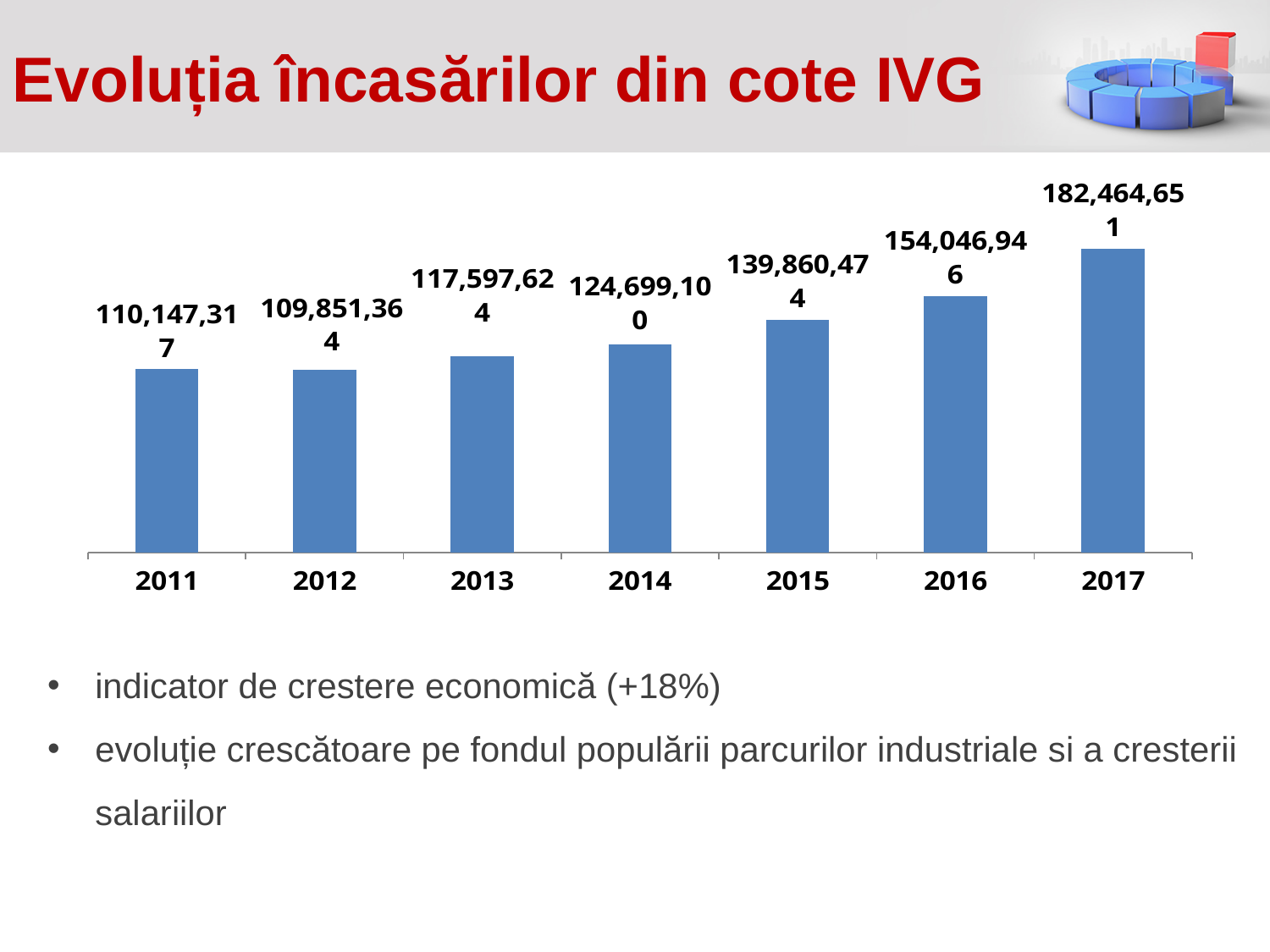
Which year has the lowest value? 2012 What is the value for 2014? 124,699,100 Do the values generally rise or fall from 2012 to 2017? rise How many years are shown on the x axis? 7 Which year has the highest value? 2017 What is the title of the slide containing the chart? Evoluția încasărilor din cote IVG What is the difference between the values for 2017 and 2016? 28,417,705 Which is larger, the value for 2013 or the value for 2014? 2014 What is the value for 2016? 154,046,946 What kind of chart is shown on the slide? bar chart What is the difference between the values for 2015 and 2014? 15,161,374 What is the value for 2011? 110,147,317